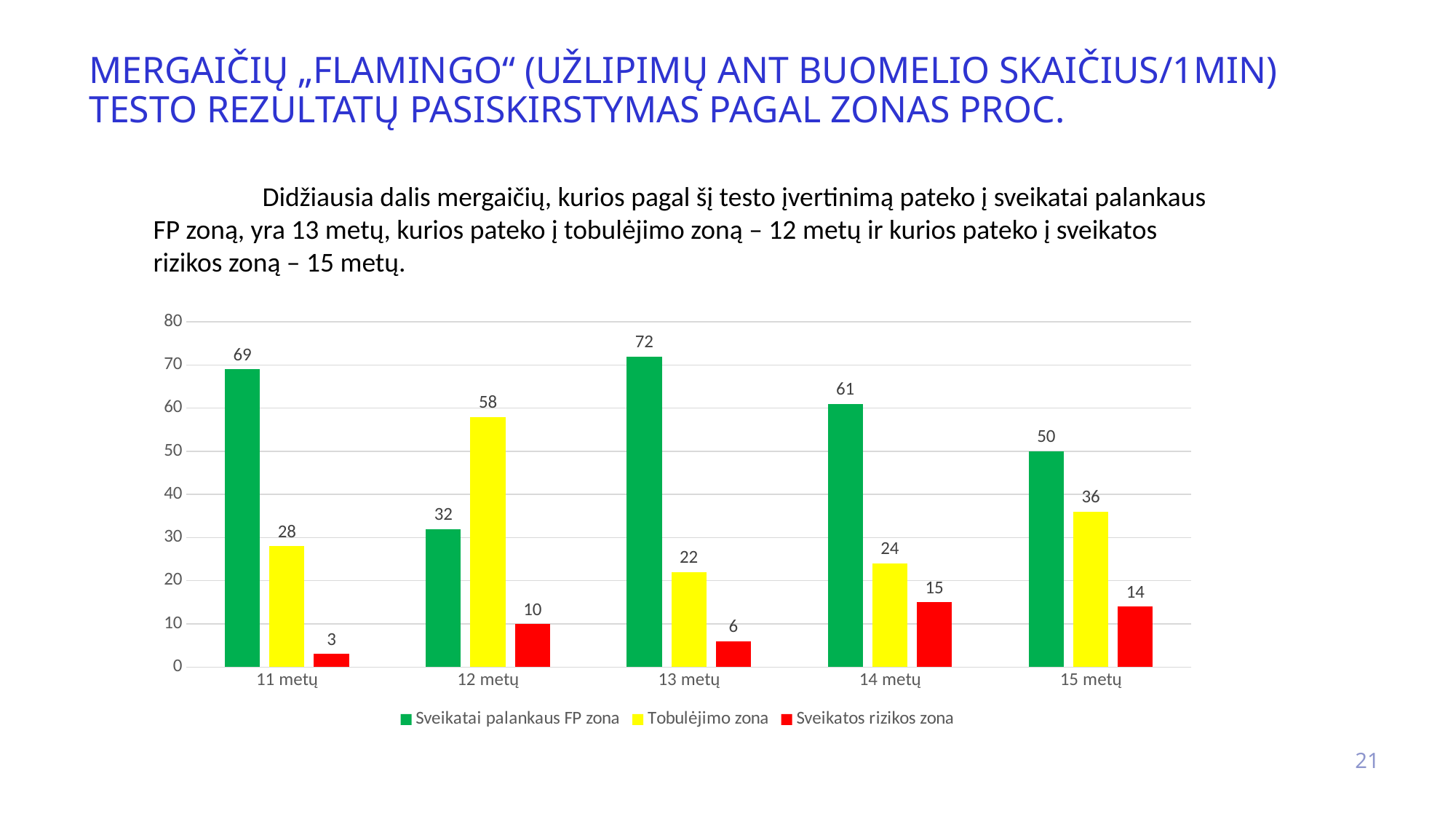
What is the value for Sveikatai palankaus FP zona for 13 metų? 72 Which age group has the highest value for Sveikatai palankaus FP zona? 13 metų How many series does the legend list? 3 What is the difference between the Sveikatai palankaus FP zona values for 13 metų and 15 metų? 22 How many age groups are shown on the x axis? 5 What is the value for Tobulėjimo zona for 12 metų? 58 What kind of chart is shown on the slide? Bar chart What is the total of the three zone values for 14 metų? 100 Which age group has the lowest value for Sveikatos rizikos zona? 11 metų What is the value for Sveikatos rizikos zona for 11 metų? 3 Which is larger for 12 metų: Sveikatai palankaus FP zona or Tobulėjimo zona? Tobulėjimo zona Which colour represents Sveikatos rizikos zona in the chart? Red